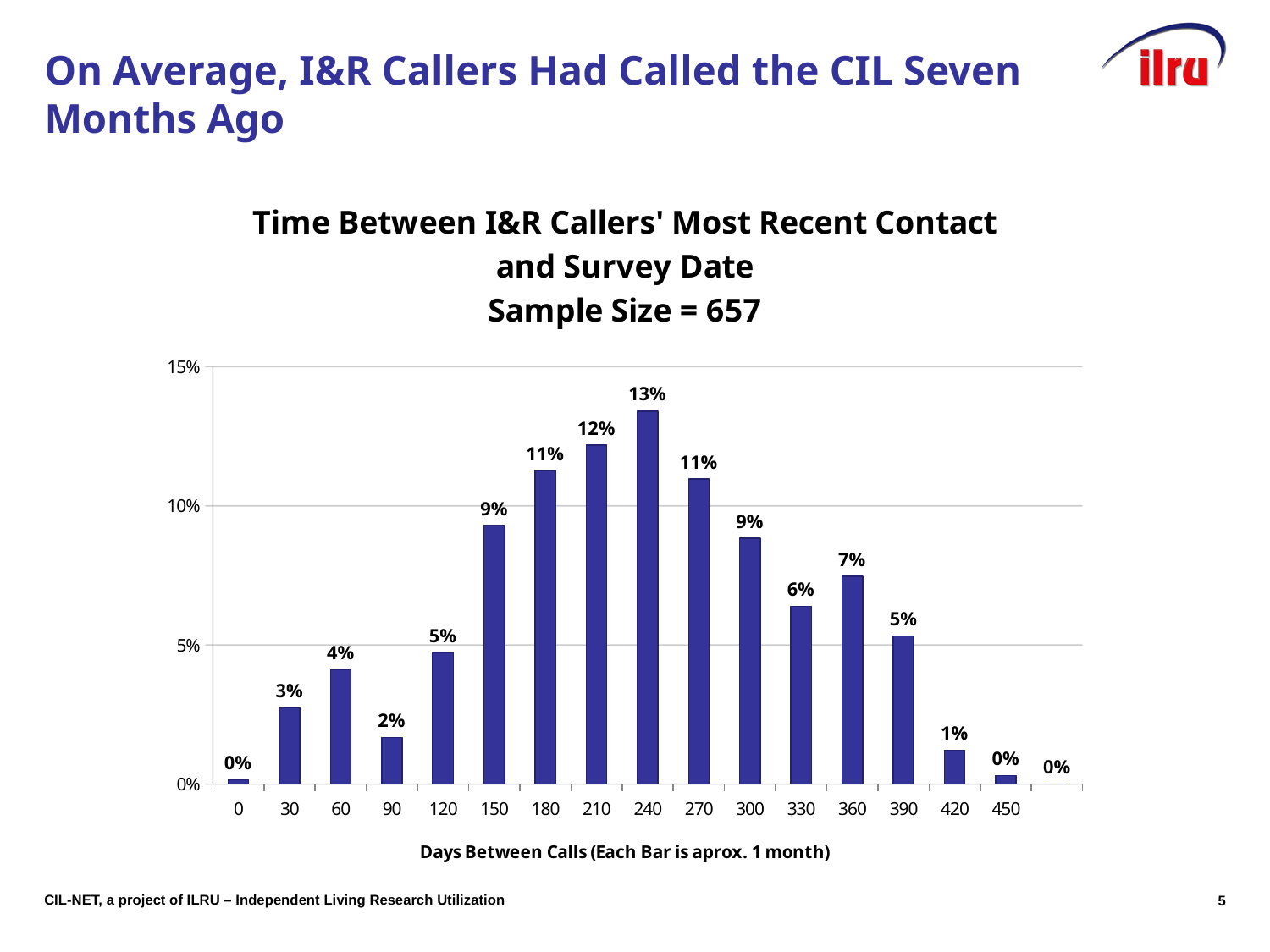
What is the value for the 240 days category? 13% Which is larger, the value for 150 days or the value for 120 days? 150 days What is the value for the 150 days category? 9% Is the value for 210 days greater or less than 10%? greater Do the values rise or fall along the x axis from 240 days to 450 days? Fall What is the difference between the values for 240 days and 150 days? 4% What is the value for the 390 days category? 5% What is the difference between the values for 180 days and 60 days? 7% What sample size is stated in the chart title? 657 What kind of chart is shown on the slide? Bar chart Which days-between-calls category has the highest value? 240 What is the x-axis title of the chart? Days Between Calls (Each Bar is aprox. 1 month)